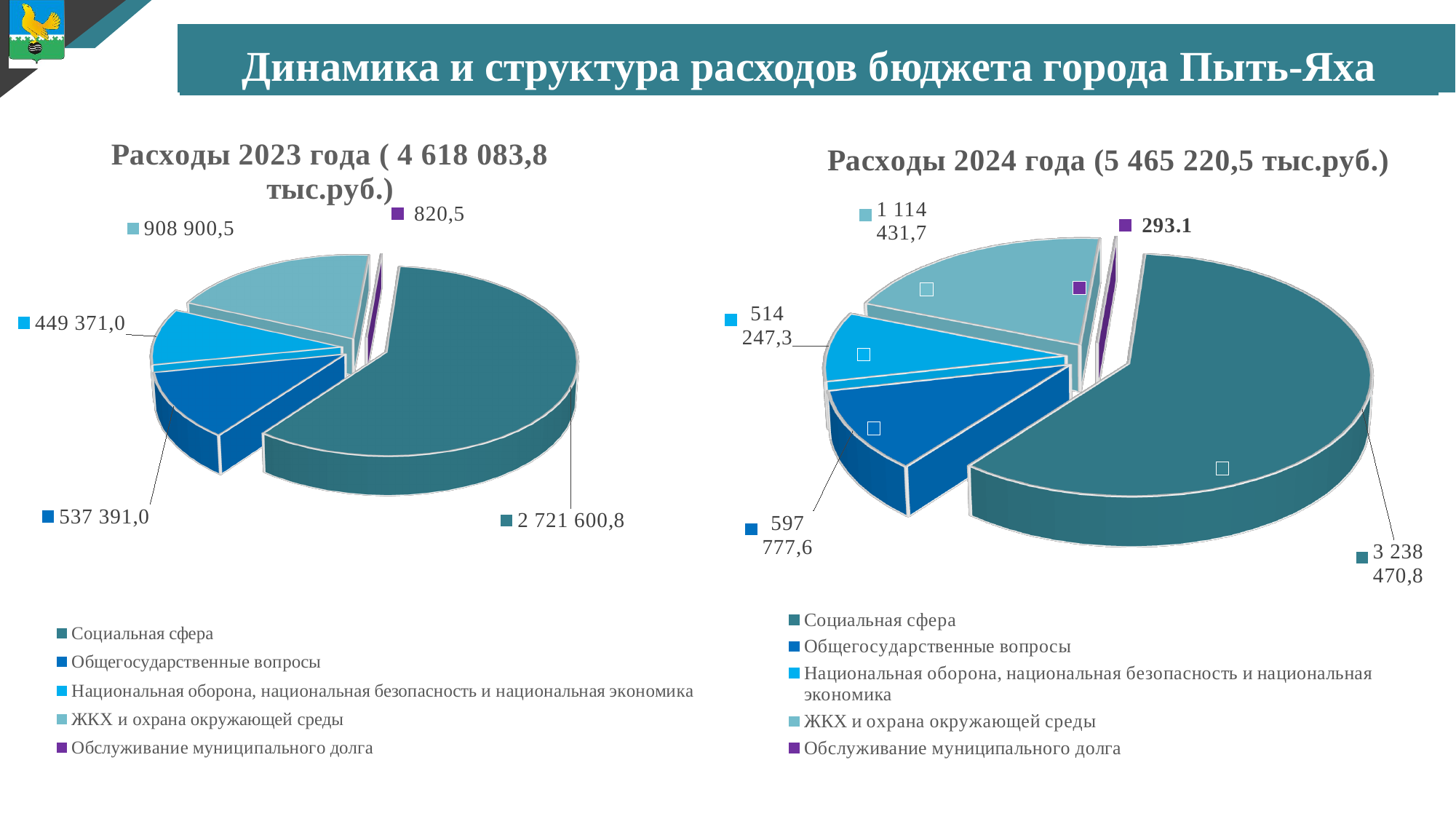
On the 'Расходы 2023 года' chart, what is the value for Национальная оборона, национальная безопасность и национальная экономика? 449 371,0 How many slices does the 'Расходы 2024 года' chart have? 5 What total is given in the title of the 'Расходы 2024 года' chart? 5 465 220,5 тыс.руб. On the 'Расходы 2024 года' chart, which category has the largest value? Социальная сфера On the 'Расходы 2023 года' chart, which category has the smallest value? Обслуживание муниципального долга On the 'Расходы 2024 года' chart, what is the value for Обслуживание муниципального долга? 293.1 On the 'Расходы 2023 года' chart, what is the value for Социальная сфера? 2 721 600,8 On the 'Расходы 2024 года' chart, what is the value for ЖКХ и охрана окружающей среды? 1 114 431,7 What type of chart is used for 'Расходы 2023 года'? Pie chart On the 'Расходы 2023 года' chart, what is the difference between ЖКХ и охрана окружающей среды and Общегосударственные вопросы? 371 509,5 On the 'Расходы 2023 года' chart, which is larger: ЖКХ и охрана окружающей среды or Общегосударственные вопросы? ЖКХ и охрана окружающей среды By how much did the value for Социальная сфера on the 'Расходы 2024 года' chart exceed the value on the 'Расходы 2023 года' chart? 516 870,0